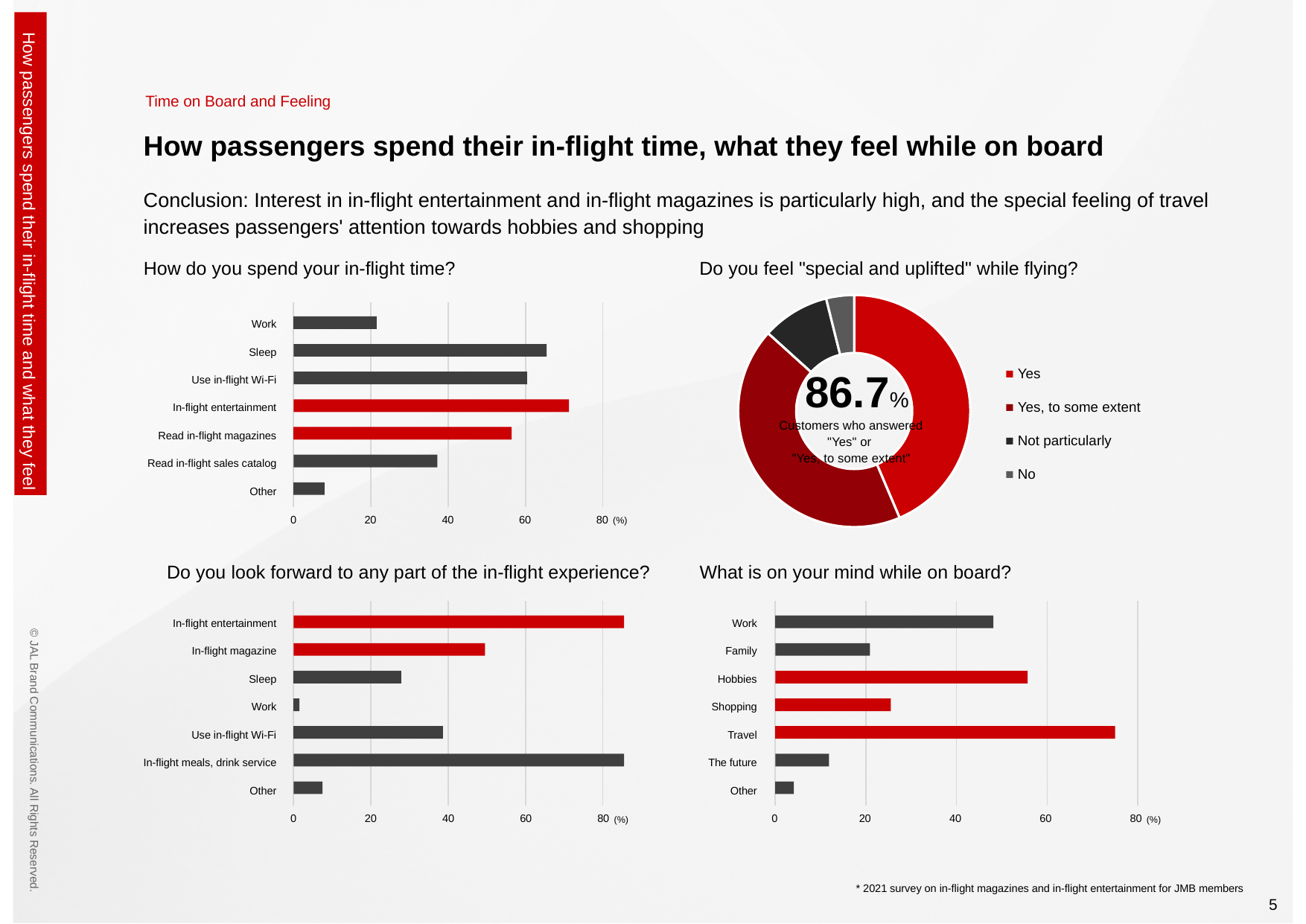
In the chart "Do you feel "special and uplifted" while flying?", what percentage of customers answered "Yes" or "Yes, to some extent"? 86.7% In the chart "Do you look forward to any part of the in-flight experience?", which category has the lowest value? Work In the chart "How do you spend your in-flight time?", which category has the lowest value? Other In the chart "What is on your mind while on board?", which is larger, Hobbies or Shopping? Hobbies In the chart "How do you spend your in-flight time?", is the value for Sleep greater or less than 60? greater In the chart "How do you spend your in-flight time?", is the value for Work greater or less than 40? less In the chart "How do you spend your in-flight time?", which category has the highest value? In-flight entertainment In the chart "How do you spend your in-flight time?", how many categories are shown? 7 What kind of chart is "Do you feel "special and uplifted" while flying?"? doughnut chart In the chart "Do you look forward to any part of the in-flight experience?", is the value for In-flight magazine greater or less than 40? greater In the chart "What is on your mind while on board?", which category has the highest value? Travel How many entries does the legend of the chart "Do you feel "special and uplifted" while flying?" list? 4